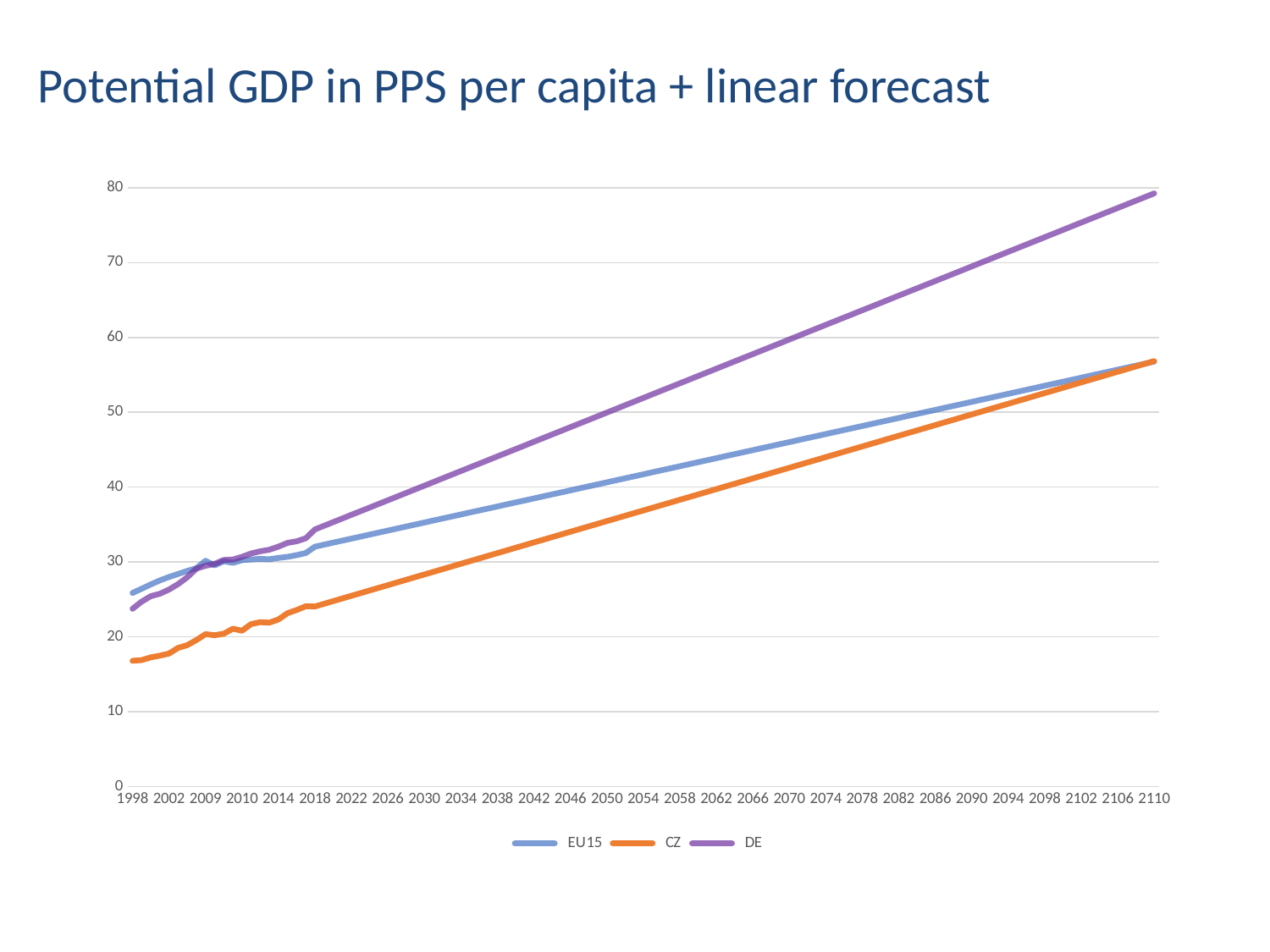
Which series has the lowest value at 1998? CZ How many series does the legend list? 3 What kind of chart is shown on the slide? line chart Which series is shown in orange in the legend? CZ Which series has the highest value at 2110? DE Is the value for DE at 2110 greater or less than 70? greater Do the values for DE rise or fall from 1998 to 2110? rise At 2110, which is larger: the value for DE or the value for CZ? DE At 1998, which is larger: the value for EU15 or the value for CZ? EU15 What is the title of the chart? Potential GDP in PPS per capita + linear forecast Is the value for CZ at 2110 greater or less than 50? greater Is the value for CZ at 1998 greater or less than 20? less